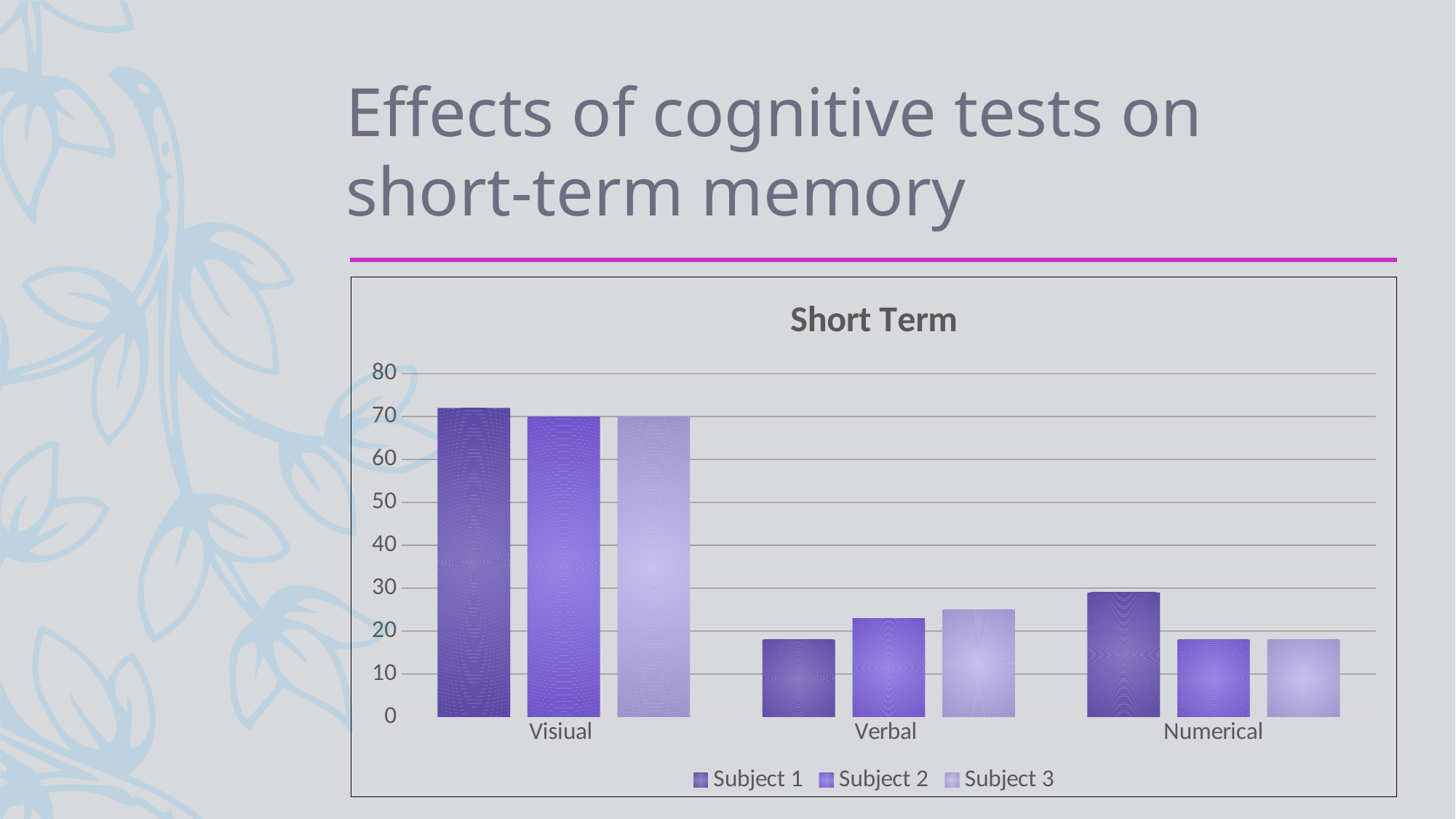
Is the value for Subject 1 in the Visual category greater or less than 60? greater How many categories are shown on the x axis? 3 Which subject has the highest value in the Numerical category? Subject 1 How many series does the legend list? 3 Which category has the highest value for Subject 1? Visiual Is the value for Subject 3 in the Verbal category greater or less than 20? greater What is the title of the chart? Short Term What kind of chart is shown on the slide? bar chart Which subject has the highest value in the Verbal category? Subject 3 Which category has the lowest value for Subject 1? Verbal Which is larger in the Numerical category, Subject 1 or Subject 2? Subject 1 Is the value for Subject 1 in the Verbal category greater or less than 20? less